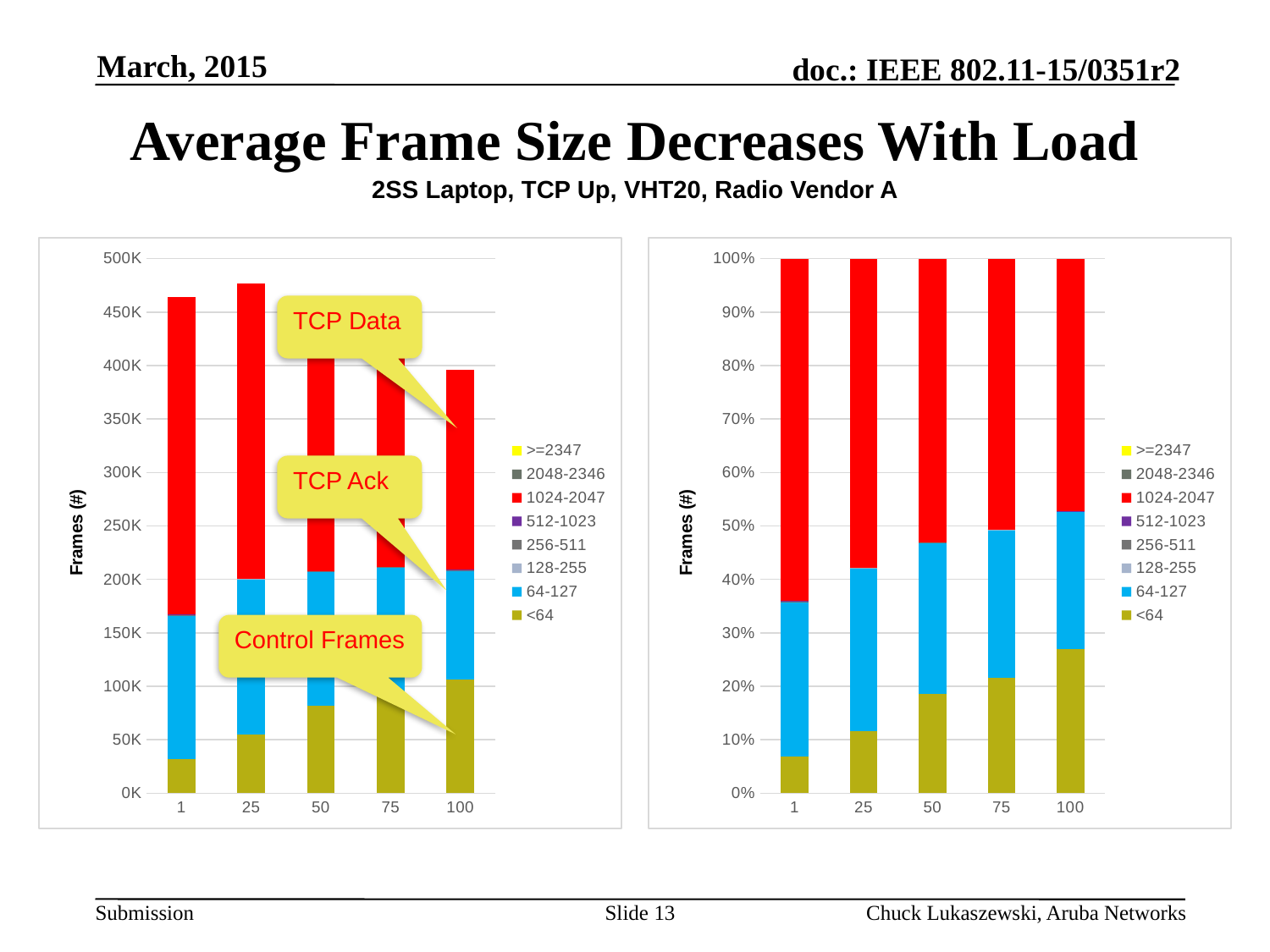
In the right chart, does the share of the 1024-2047 series rise or fall as the x axis goes from 1 to 100? fall What is the y axis title of the left chart? Frames (#) In the right chart, is the <64 share for category 1 greater or less than 10%? less In the left chart, is the total for category 1 greater or less than 450K? greater In the right chart, does the share of the <64 series rise or fall as the x axis goes from 1 to 100? rise In the left chart, is the <64 segment for category 1 greater or less than 50K? less In the left chart, which category has the highest total bar? 25 What kind of chart is the left chart on the slide? stacked bar chart How many categories are shown on the x axis of the left chart? 5 How many series does the legend of the right chart list? 8